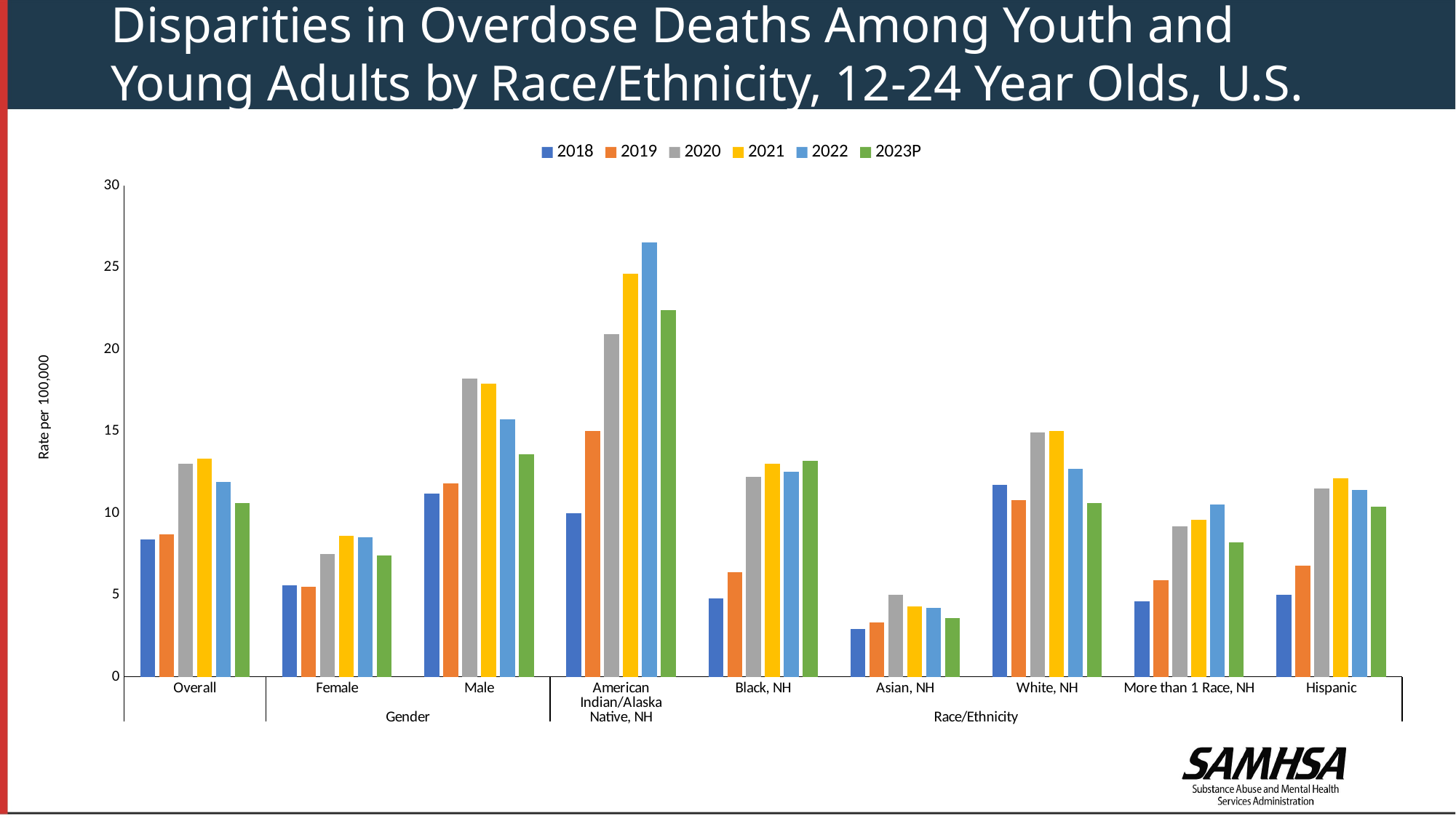
What type of chart is shown on the slide? bar chart Is the 2018 value for Female greater or less than 10? less Which category has the highest value for 2022? American Indian/Alaska Native, NH Which category has the lowest value for 2018? Asian, NH Which is larger for 2021: the value for Male or the value for Female? Male How many categories are shown along the x axis? 9 What is the label on the y axis? Rate per 100,000 Which is larger for 2018: the value for White, NH or the value for Hispanic? White, NH Is the 2020 value for Male greater or less than 15? greater Is the 2022 value for American Indian/Alaska Native, NH greater or less than 25? greater Does the Overall value rise or fall from 2021 to 2023P? fall How many series does the legend list? 6